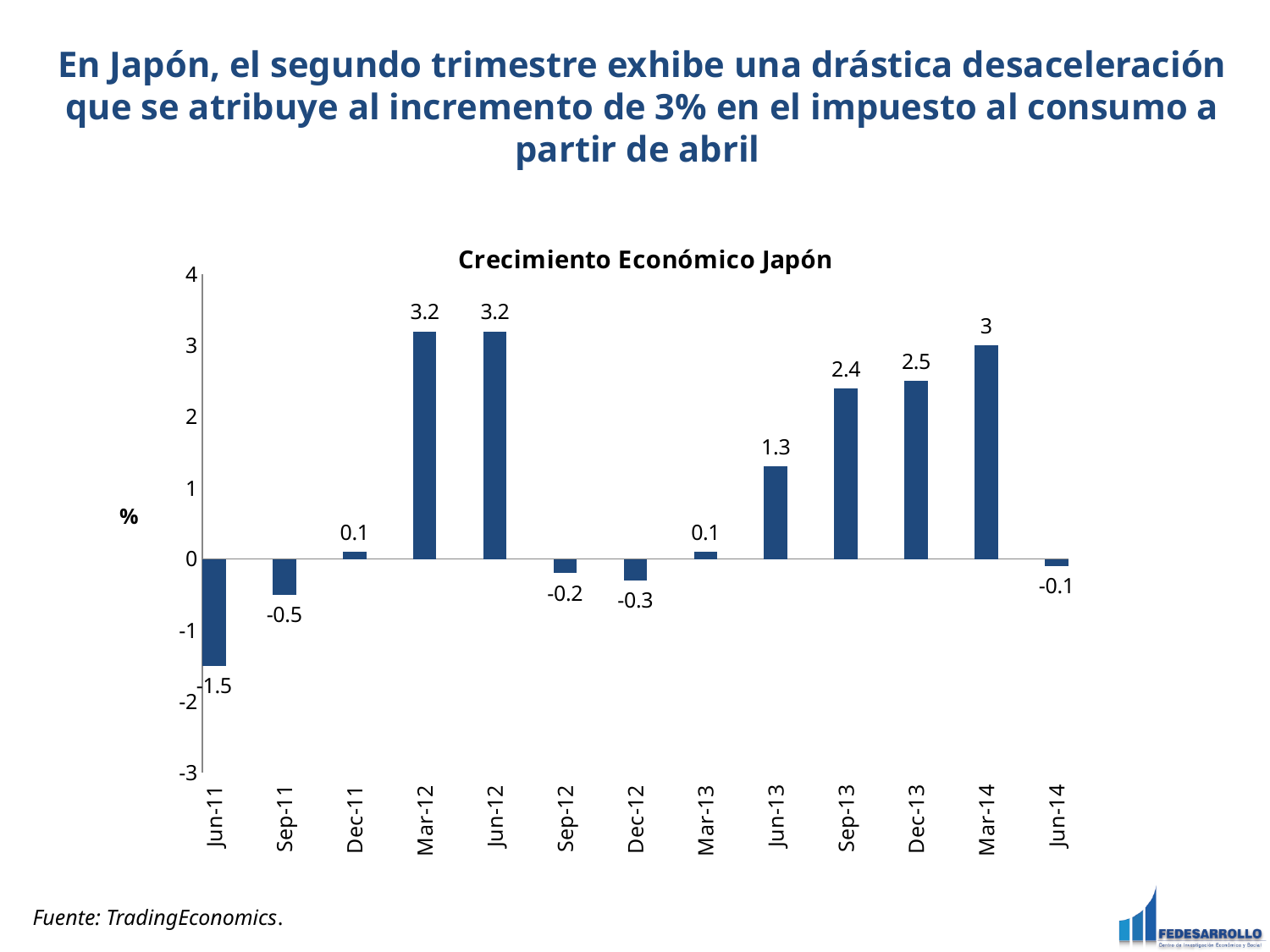
Which is larger, the value for Jun-13 or the value for Dec-13? Dec-13 What is the title of the chart? Crecimiento Económico Japón What is the value for Sep-13? 2.4 What kind of chart is shown? bar chart What is the difference between the values for Dec-13 and Sep-13? 0.1 How many quarters are shown on the x axis? 13 What is the value for Mar-14? 3 What is the value for Jun-11? -1.5 What is the value for Jun-14? -0.1 Which quarter has the lowest value? Jun-11 Is the value for Mar-12 greater or less than 3? greater What is the difference between the values for Mar-14 and Jun-14? 3.1